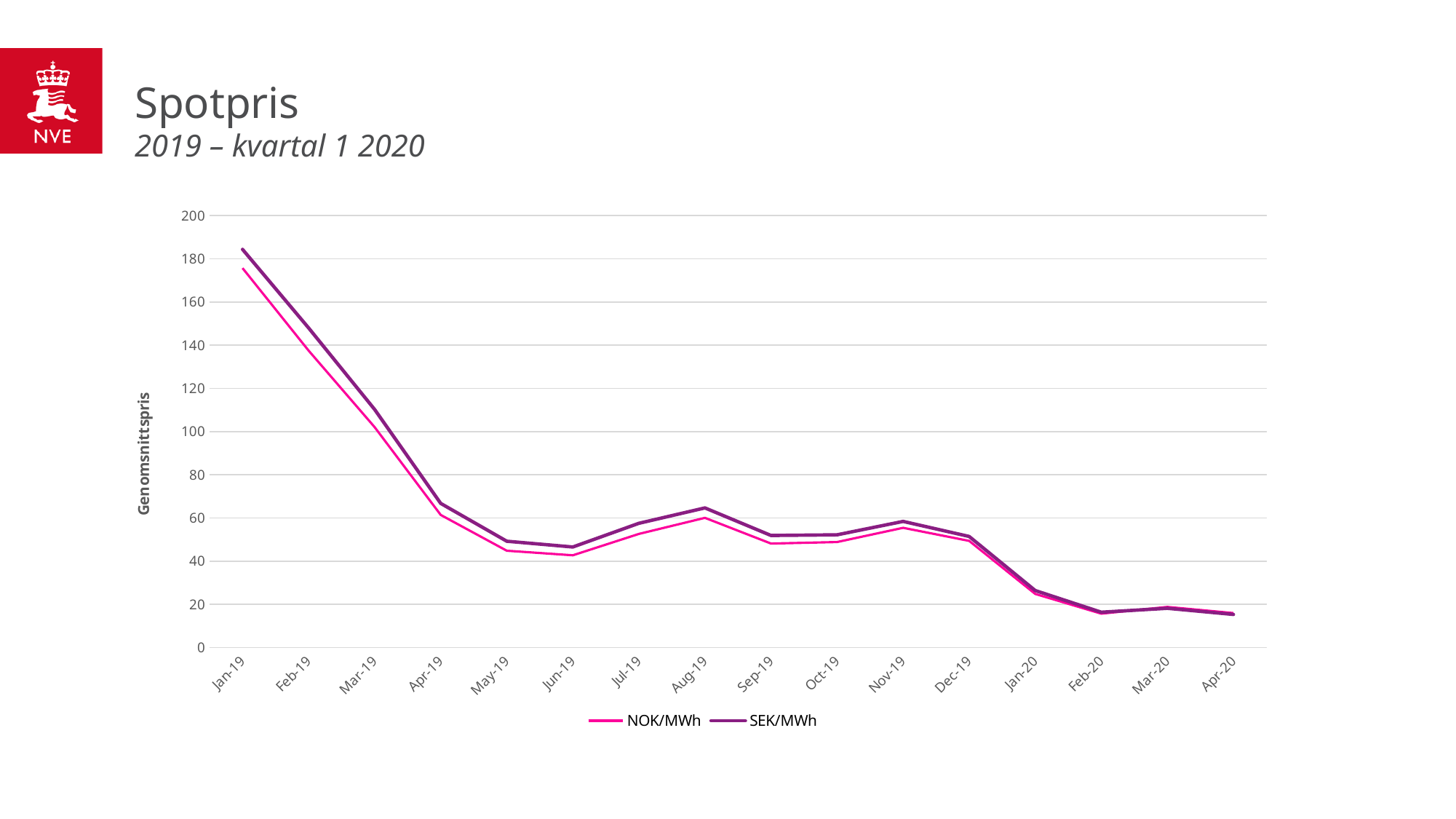
Is the NOK/MWh value for Jun-19 greater or less than 60? less Do the values generally rise or fall from Jan-19 to Apr-20? fall Which month has the highest SEK/MWh value? Jan-19 How many series does the legend list? 2 Is the SEK/MWh value for Mar-19 greater or less than 100? greater Is the SEK/MWh value for Jan-20 greater or less than 40? less What kind of chart is shown on the slide? line chart For SEK/MWh, which is larger: the value for Aug-19 or the value for Jun-19? Aug-19 What is the label on the vertical axis? Genomsnittspris How many months are plotted along the x axis? 16 Which month has the highest NOK/MWh value? Jan-19